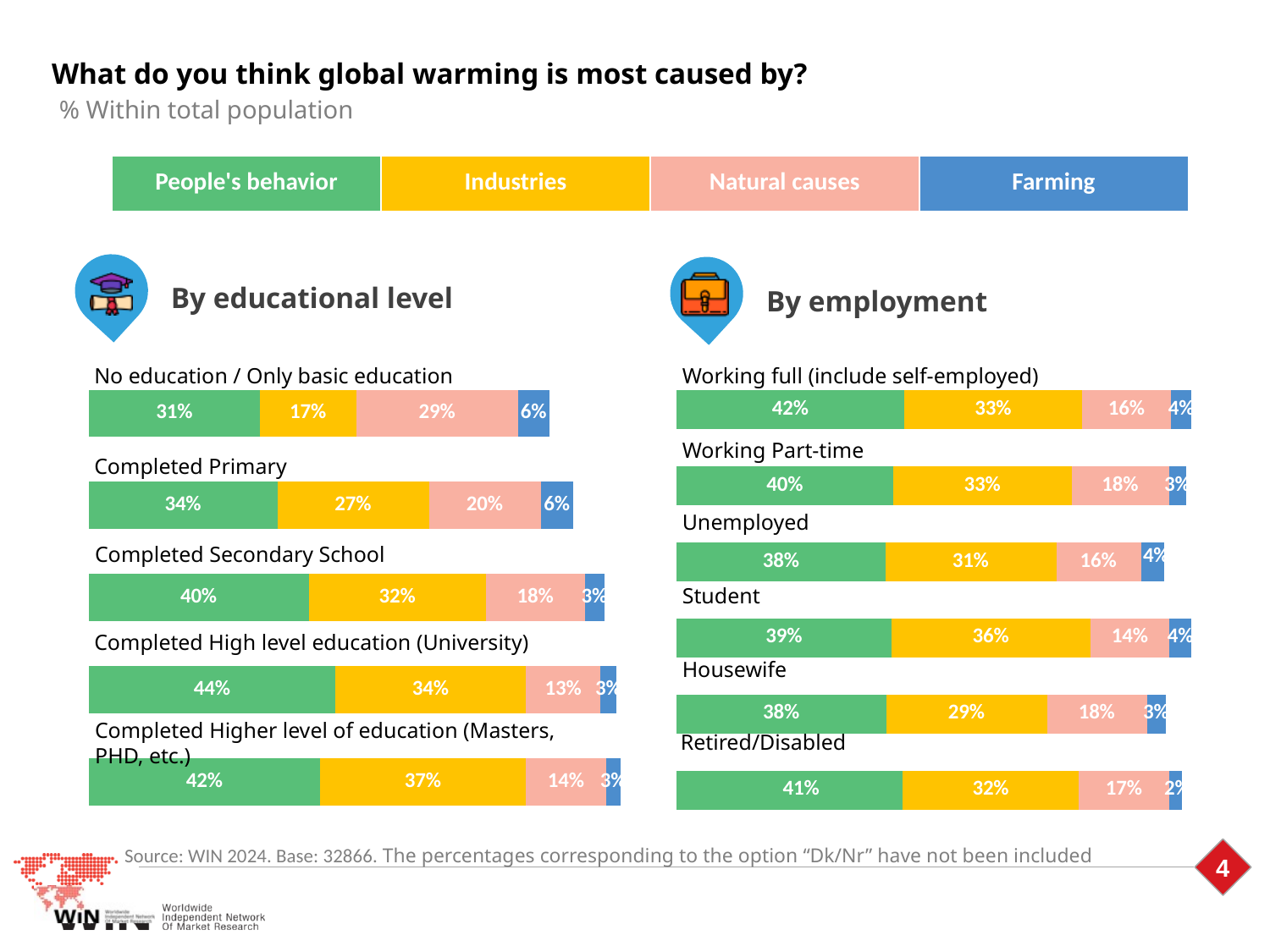
In the 'By employment' chart, which employment group has the lowest percentage for 'Farming'? Retired/Disabled What type of chart is used in the 'By employment' section? Stacked bar chart In the 'By educational level' chart, what is the total of the four labelled segments for Completed Primary? 87% Which colour represents 'Natural causes' in the legend? Pink In the 'By educational level' chart, what percentage of people with no education / only basic education think global warming is most caused by natural causes? 29% How many educational level categories are shown in the 'By educational level' chart? 5 How many employment categories are shown in the 'By employment' chart? 6 In the 'By educational level' chart, which educational level has the highest percentage for 'People's behavior'? Completed High level education (University) How many series does the legend at the top of the slide list? 4 In the 'By employment' chart, what percentage of students think global warming is most caused by industries? 36% In the 'By educational level' chart, what is the difference between the 'Industries' percentages for Completed Higher level of education (Masters, PHD, etc.) and No education / Only basic education? 20 percentage points In the 'By employment' chart, which is larger: the 'People's behavior' percentage for Working full (include self-employed) or for Unemployed? Working full (include self-employed)